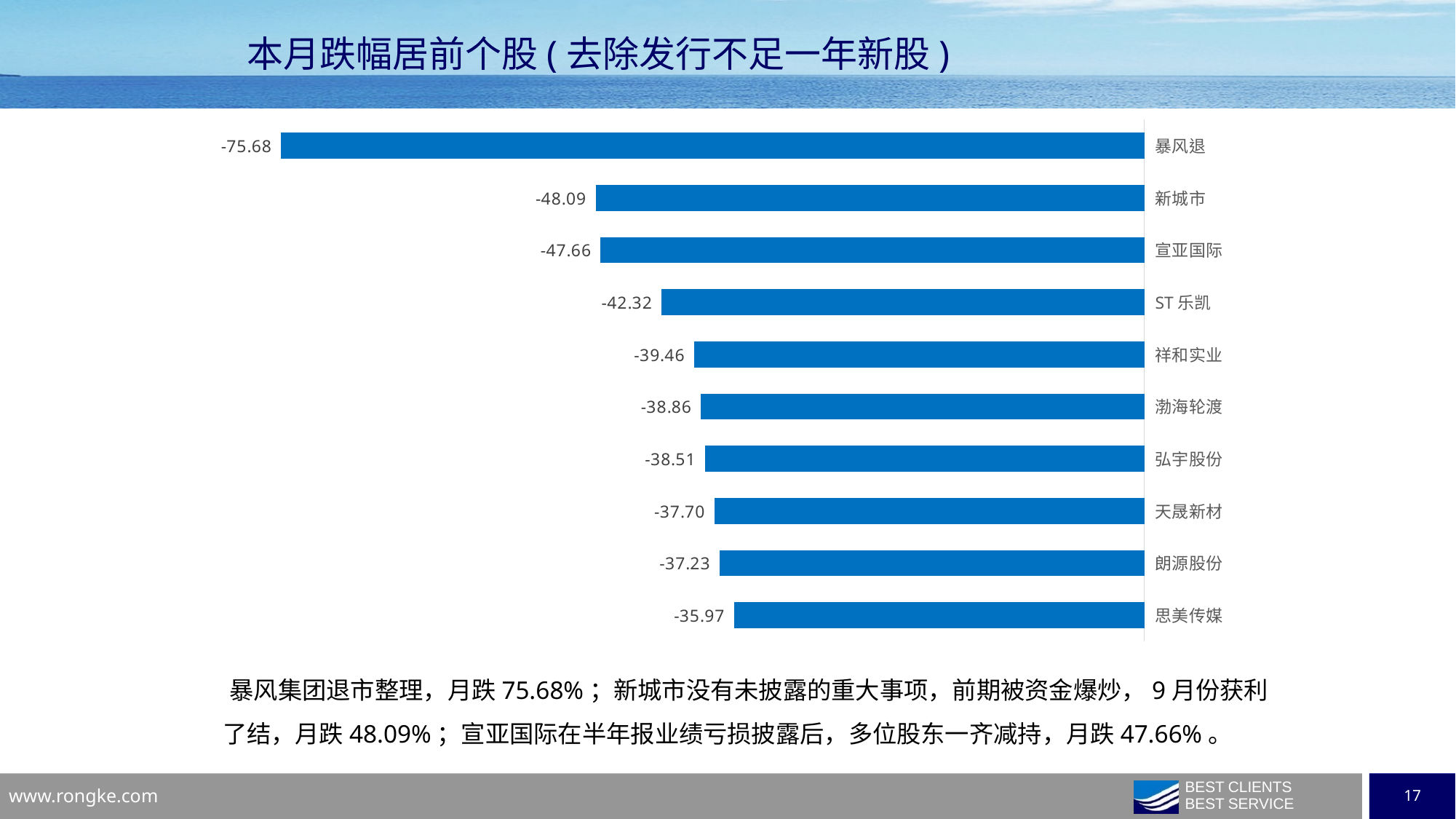
What is the value shown for 暴风退? -75.68 How many stocks are shown in the chart? 10 What is the title of the slide? 本月跌幅居前个股（去除发行不足一年新股） What is the value shown for ST 乐凯? -42.32 What is the value shown for 朗源股份? -37.23 Which stock has the largest decline (the longest bar) in the chart? 暴风退 What is the difference between the values for ST 乐凯 and 祥和实业? 2.86 What is the value shown for 宣亚国际? -47.66 Which stock has a larger decline, 渤海轮渡 or 弘宇股份? 渤海轮渡 What is the difference between the values for 暴风退 and 新城市? 27.59 Which stock has the smallest decline (the shortest bar) in the chart? 思美传媒 What type of chart is shown on the slide? Bar chart